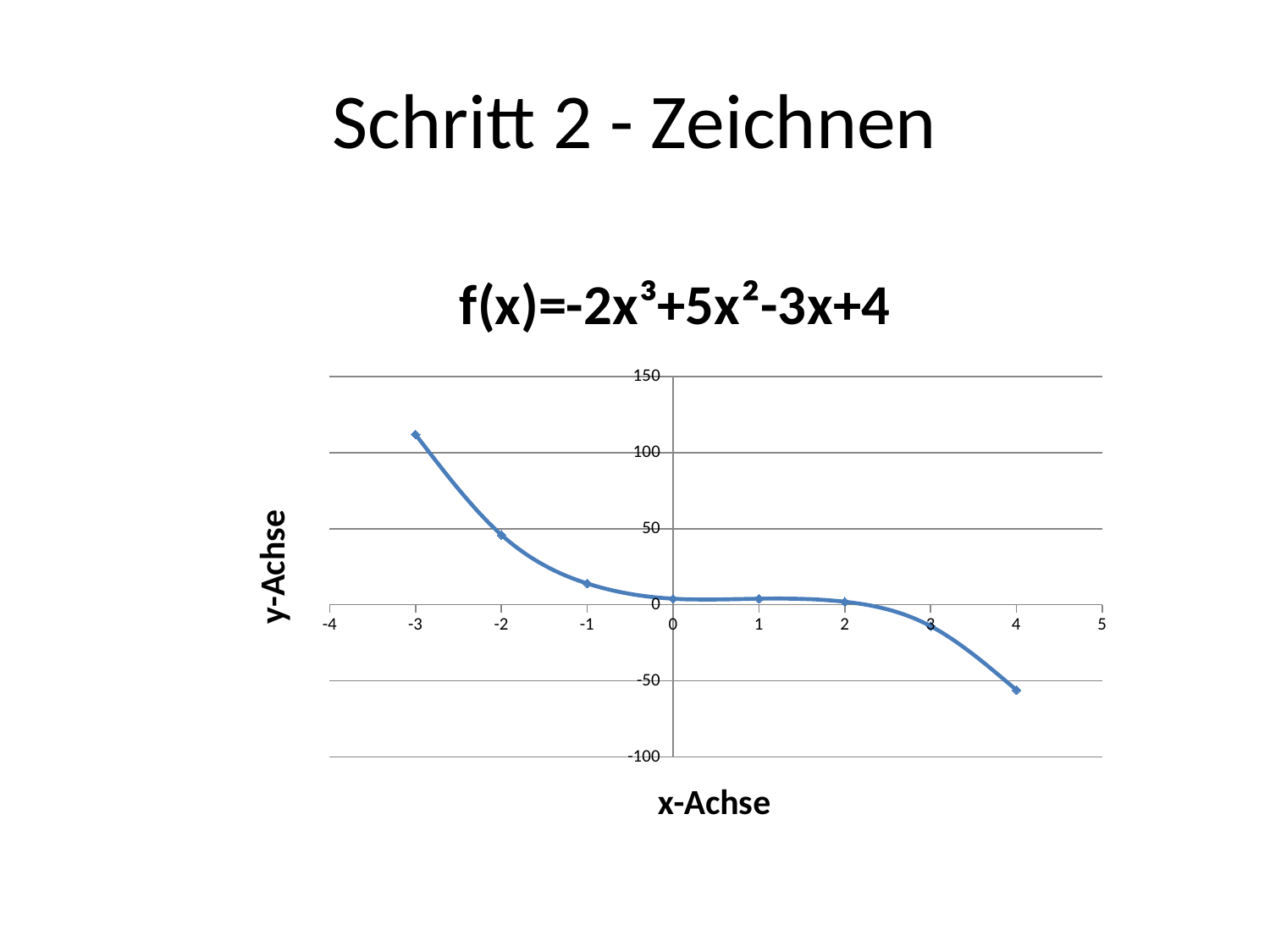
Do the y values generally rise or fall as x increases from -3 to 4? fall At which x value does the curve reach its lowest y value? 4 Is the y value at x = 4 greater or less than -50? less Is the y value at x = 3 greater or less than 0? less Which has the larger y value, x = -1 or x = 3? x = -1 What is the label of the horizontal axis? x-Achse At which x value does the curve reach its highest y value? -3 Is the y value at x = -3 greater or less than 100? greater What is the title of the chart? f(x)=-2x³+5x²-3x+4 What kind of chart is shown on the slide? line chart How many data points are plotted on the curve? 8